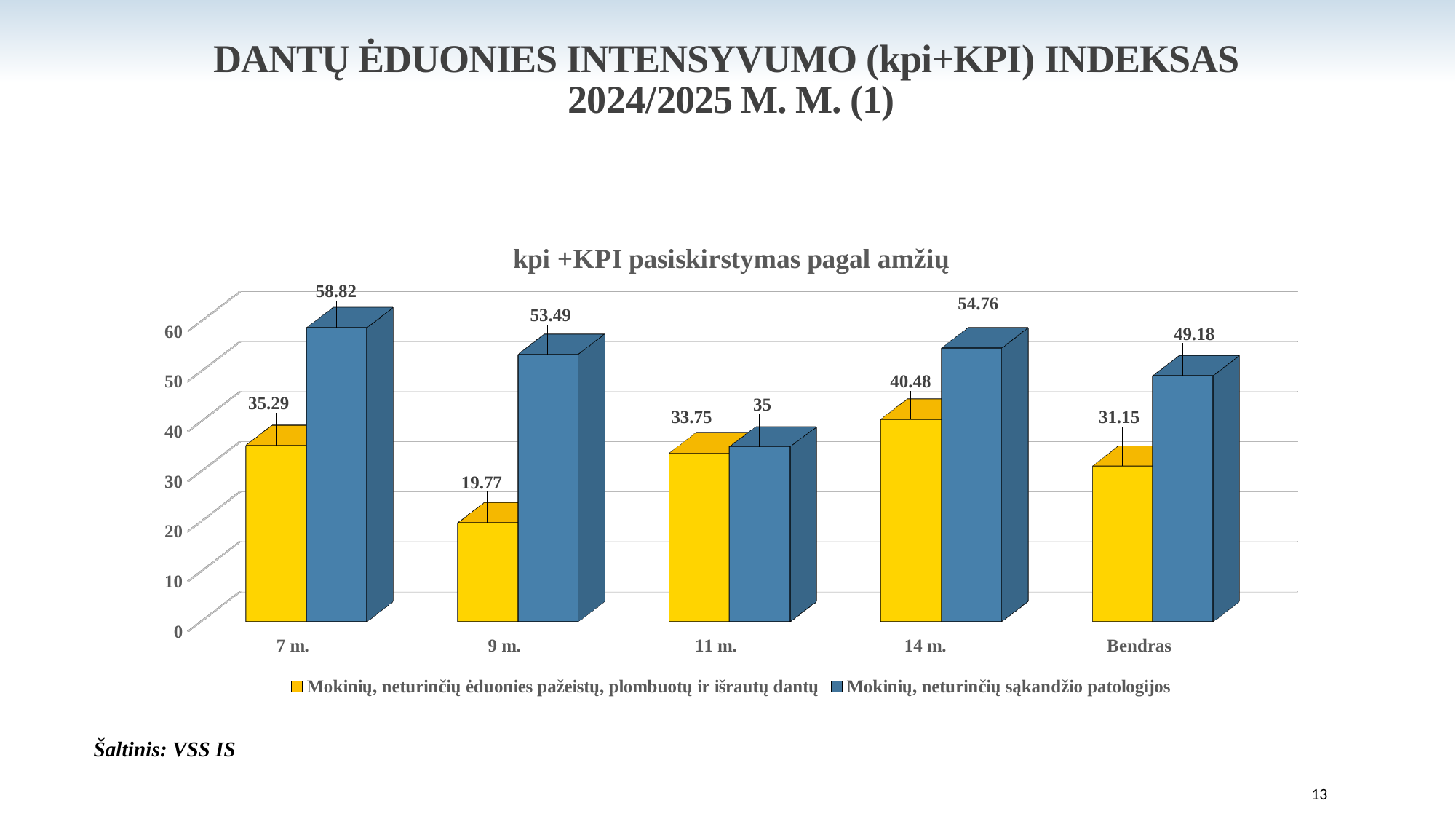
What kind of chart is shown on the slide? Bar chart How many series does the legend list? 2 For 14 m., which series has the larger value? Mokinių, neturinčių sąkandžio patologijos Which category has the lowest value in the series 'Mokinių, neturinčių sąkandžio patologijos'? 11 m. What is the value for 9 m. in the series 'Mokinių, neturinčių ėduonies pažeistų, plombuotų ir išrautų dantų'? 19.77 Which category has the highest value in the series 'Mokinių, neturinčių ėduonies pažeistų, plombuotų ir išrautų dantų'? 14 m. What is the title of the chart? kpi +KPI pasiskirstymas pagal amžių What is the value for 11 m. in the series 'Mokinių, neturinčių sąkandžio patologijos'? 35 How many categories are shown on the x axis? 5 What is the value for Bendras in the series 'Mokinių, neturinčių sąkandžio patologijos'? 49.18 What is the value for 7 m. in the series 'Mokinių, neturinčių sąkandžio patologijos'? 58.82 What is the difference between the two series' values for 7 m.? 23.53